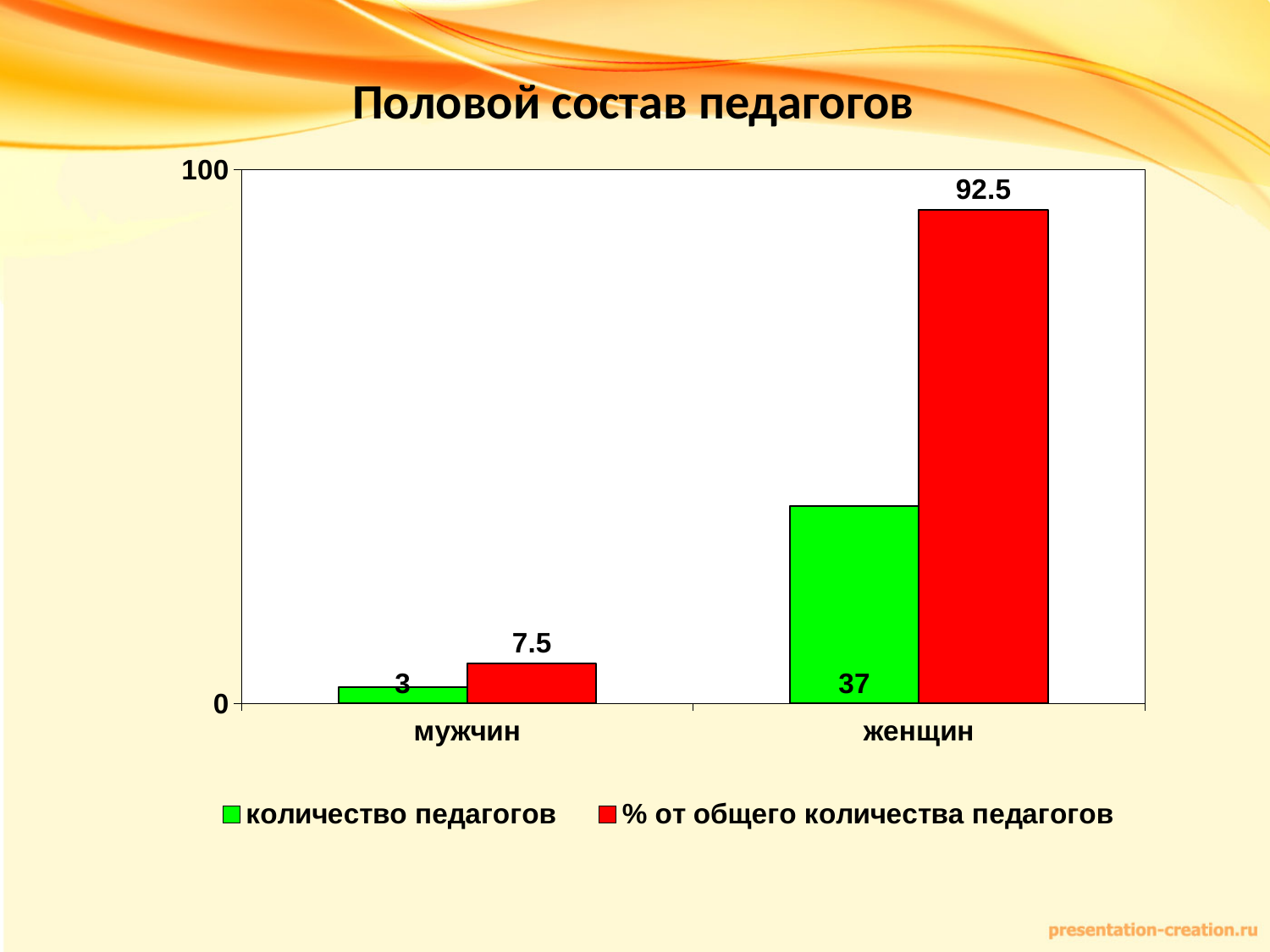
Which category has the higher value for 'количество педагогов'? женщин How many series does the legend list? 2 What is the value of 'количество педагогов' for 'мужчин'? 3 What is the value of 'количество педагогов' for 'женщин'? 37 What is the difference between the '% от общего количества педагогов' values for 'женщин' and 'мужчин'? 85 What is the difference between the 'количество педагогов' values for 'женщин' and 'мужчин'? 34 Which category has the lowest value for '% от общего количества педагогов'? мужчин What type of chart is shown on the slide? Bar chart How many categories are shown on the x axis? 2 What is the value of '% от общего количества педагогов' for 'мужчин'? 7.5 Is the '% от общего количества педагогов' value for 'женщин' larger than the 'количество педагогов' value for 'женщин'? Yes What is the value of '% от общего количества педагогов' for 'женщин'? 92.5